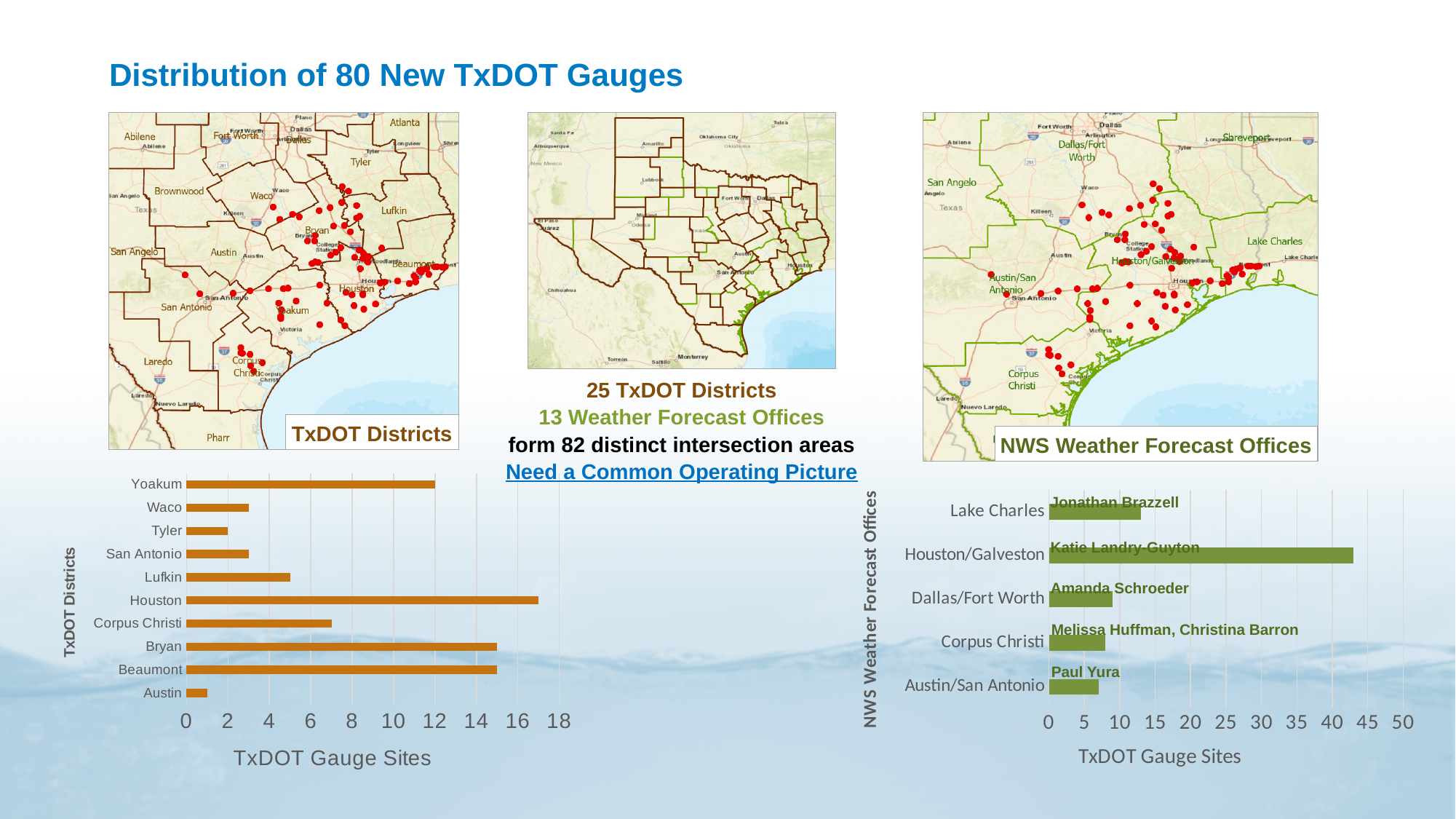
In the bottom-left TxDOT Districts chart, which has more gauge sites, Houston or Yoakum? Houston What kind of chart is the TxDOT Districts chart at the bottom left of the slide? bar chart What is the x-axis title of the bottom-left TxDOT Districts chart? TxDOT Gauge Sites In the bottom-right NWS Weather Forecast Offices chart, is the value for Lake Charles greater or less than 10? greater How many TxDOT districts are listed in the bottom-left bar chart? 10 In the bottom-left TxDOT Districts chart, is the value for Lufkin greater or less than 4? greater How many NWS Weather Forecast Offices are listed in the bottom-right bar chart? 5 In the bottom-left TxDOT Districts chart, which district has the fewest TxDOT gauge sites? Austin In the bottom-left TxDOT Districts chart, which district has the most TxDOT gauge sites? Houston In the bottom-right NWS Weather Forecast Offices chart, is the value for Houston/Galveston greater or less than 40? greater In the bottom-right NWS Weather Forecast Offices chart, which office has the most TxDOT gauge sites? Houston/Galveston